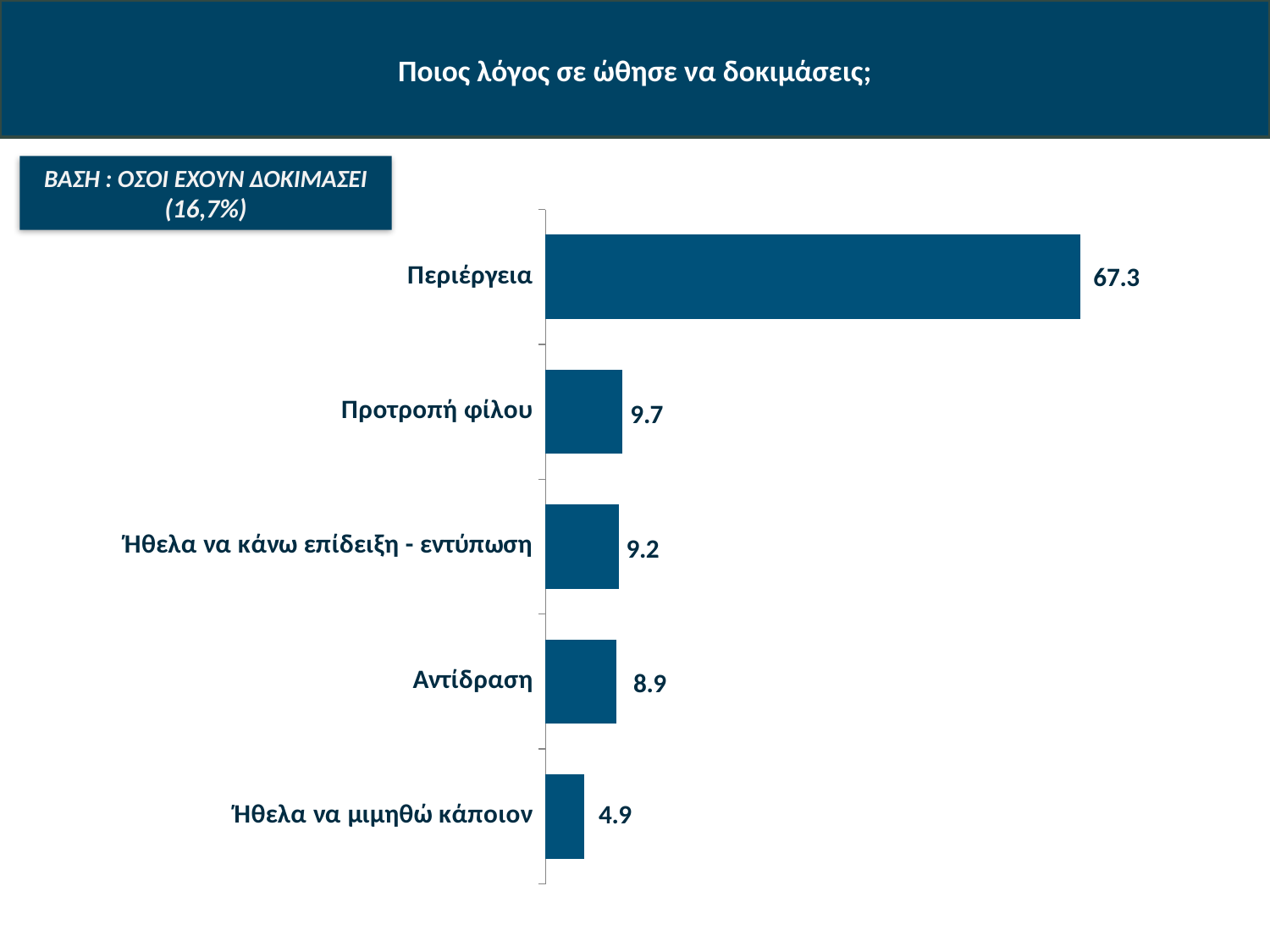
What is the difference between the values for Αντίδραση and Ήθελα να μιμηθώ κάποιον? 4.0 How many categories are shown in the chart? 5 What is the value for Προτροπή φίλου? 9.7 What is the difference between the values for Περιέργεια and Προτροπή φίλου? 57.6 Which category has the highest value? Περιέργεια Which category has the lowest value? Ήθελα να μιμηθώ κάποιον What kind of chart is shown on the slide? Bar chart What is the value for Ήθελα να μιμηθώ κάποιον? 4.9 What is the value for Αντίδραση? 8.9 What is the value for Ήθελα να κάνω επίδειξη - εντύπωση? 9.2 What is the title of the slide? Ποιος λόγος σε ώθησε να δοκιμάσεις; What is the value for Περιέργεια? 67.3